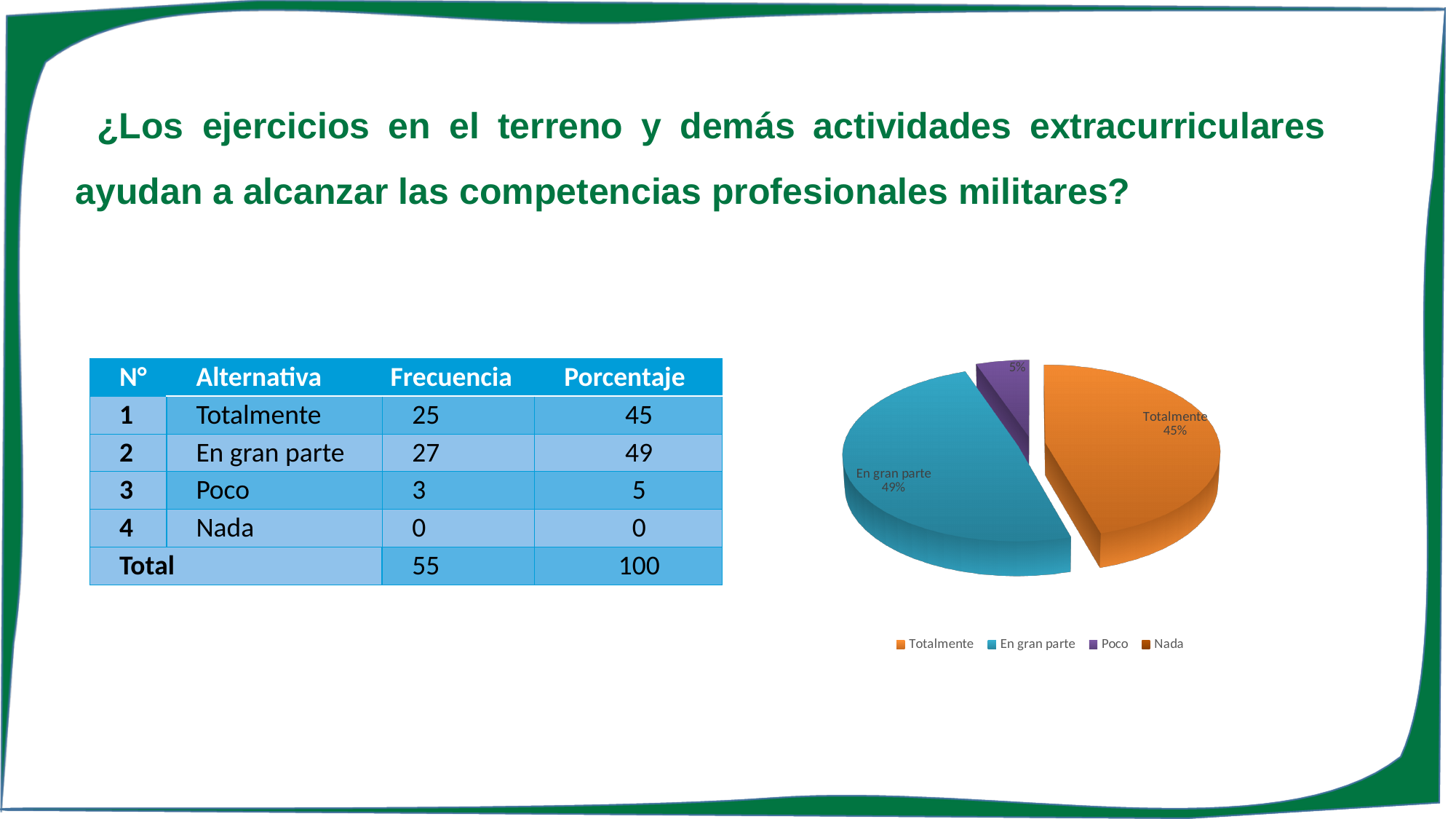
Which category has the largest slice in the pie chart? En gran parte What colour is the Totalmente slice in the pie chart? orange What kind of chart is shown on the slide? pie chart What percentage does the pie chart show for Poco? 5% What percentage does the pie chart show for Totalmente? 45% Which labelled slice in the pie chart is the smallest? Poco What is the difference in percentage points between Totalmente and Poco in the pie chart? 40 How many entries does the pie chart's legend list? 4 What percentage does the pie chart show for En gran parte? 49% What colour is the En gran parte slice in the pie chart? blue What is the difference in percentage points between En gran parte and Totalmente in the pie chart? 4 Which is larger in the pie chart, Totalmente or Poco? Totalmente